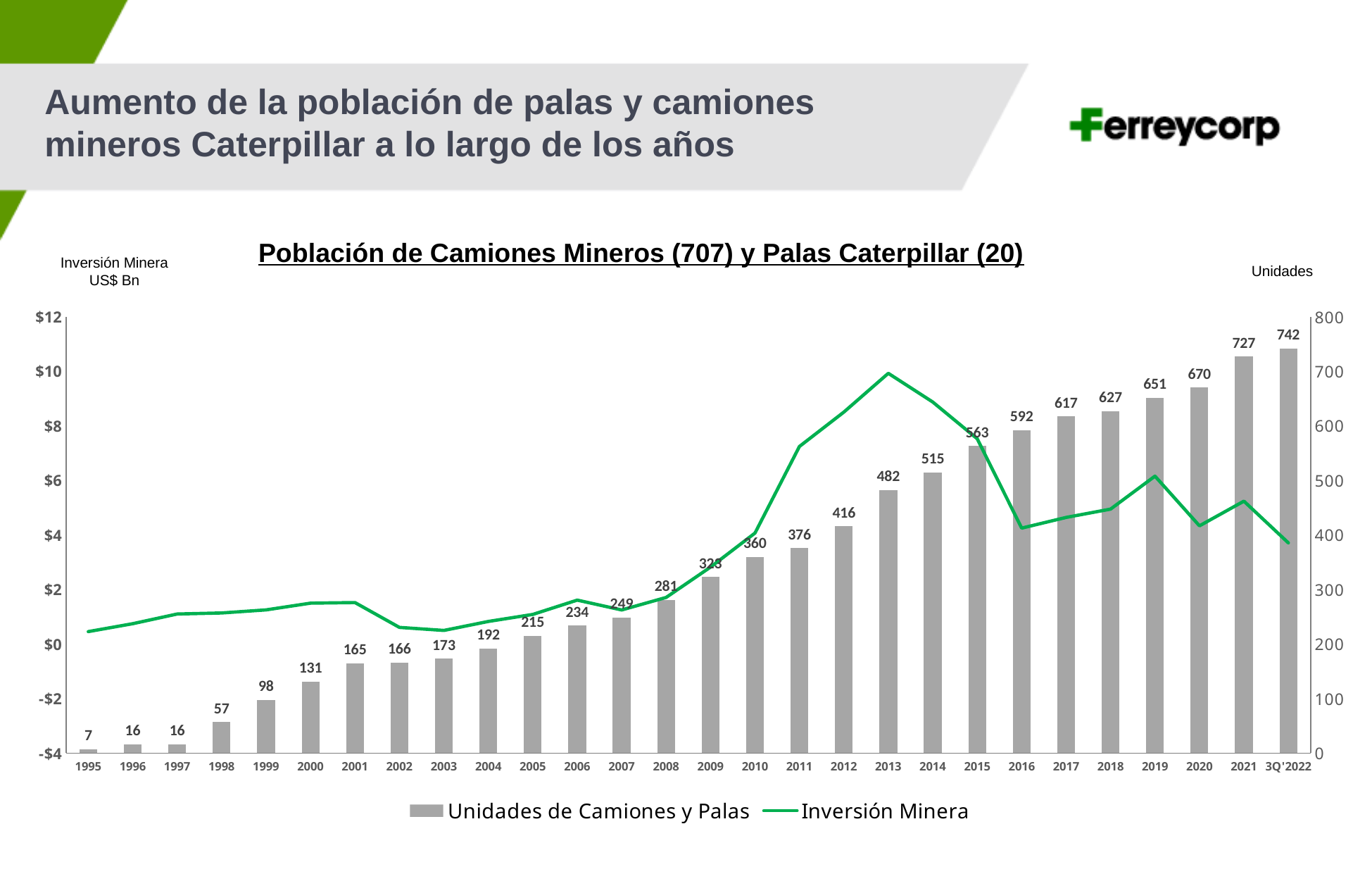
Is the Inversión Minera value for 2013 greater or less than $8? greater How many series does the legend list? 2 Which is larger, the Unidades de Camiones y Palas value for 2015 or for 2016? 2016 What is the value of Unidades de Camiones y Palas for 3Q'2022? 742 What is the value of Unidades de Camiones y Palas for 2000? 131 Is the Inversión Minera value for 1995 greater or less than $2? less Do the Unidades de Camiones y Palas values generally rise or fall from 1995 to 3Q'2022? Rise Which category has the highest value of Unidades de Camiones y Palas? 3Q'2022 What is the difference in Unidades de Camiones y Palas between 2021 and 2020? 57 Which year has the lowest value of Unidades de Camiones y Palas? 1995 What type of chart is shown on the slide? Combined bar and line chart What is the value of Unidades de Camiones y Palas for 2013? 482